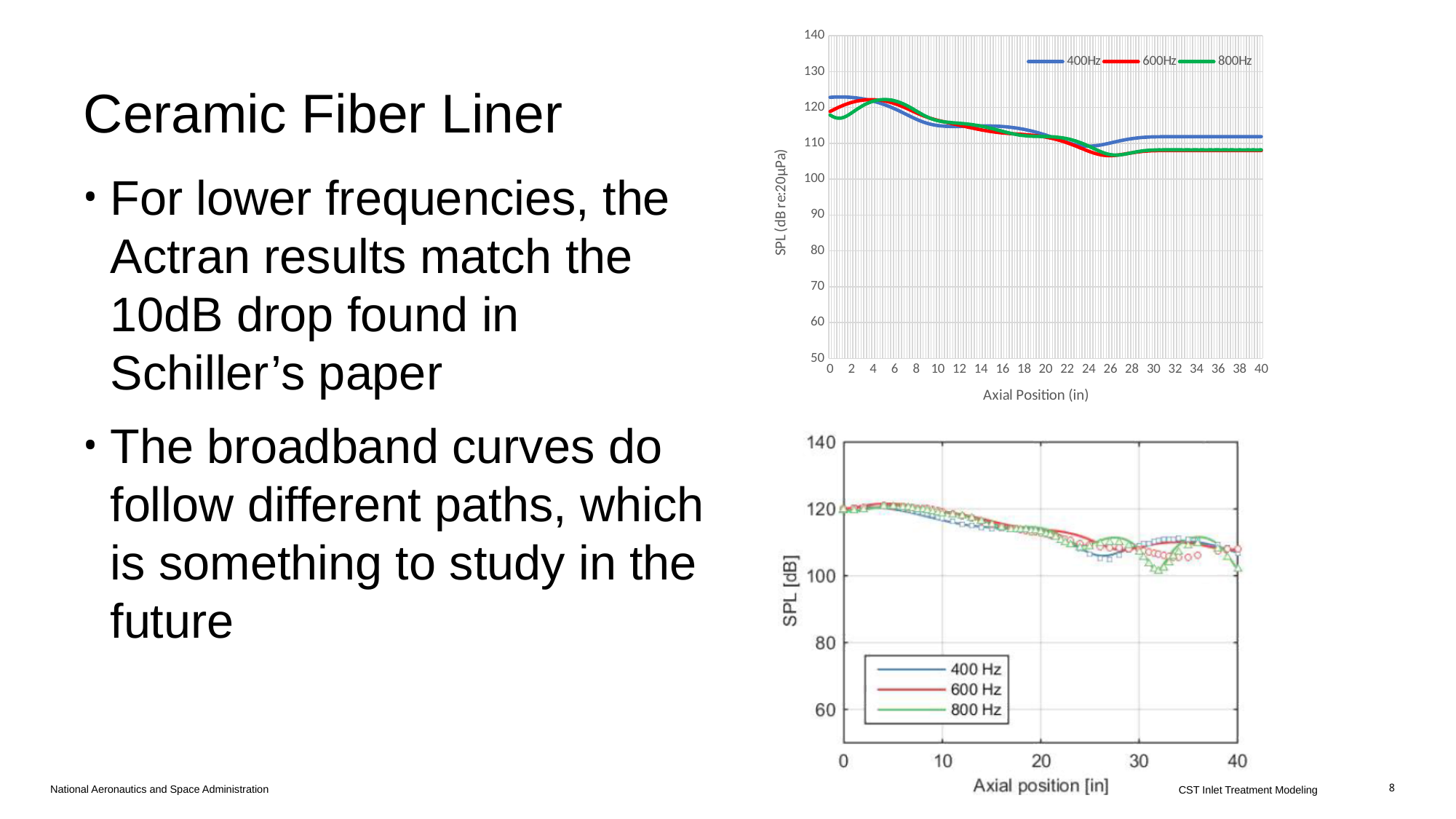
In the top chart, what is the label of the x axis? Axial Position (in) How many series does the legend of the bottom chart list? 3 In the top chart, which series has the higher value at axial position 40, 400Hz or 800Hz? 400Hz In the top chart, is the value of the 800Hz series at axial position 0 greater or less than 120? less In the top chart, what is the label of the y axis? SPL (dB re:20µPa) In the top chart, is the value of the 400Hz series at axial position 40 greater or less than 110? greater In the top chart, do the SPL values generally rise or fall as axial position increases from 0 to 40? fall In the top chart, is the value of the 800Hz series at axial position 40 greater or less than 110? less What kind of chart is the top chart on the slide? line chart How many series does the legend of the top chart list? 3 What kind of chart is the bottom chart on the slide? line chart